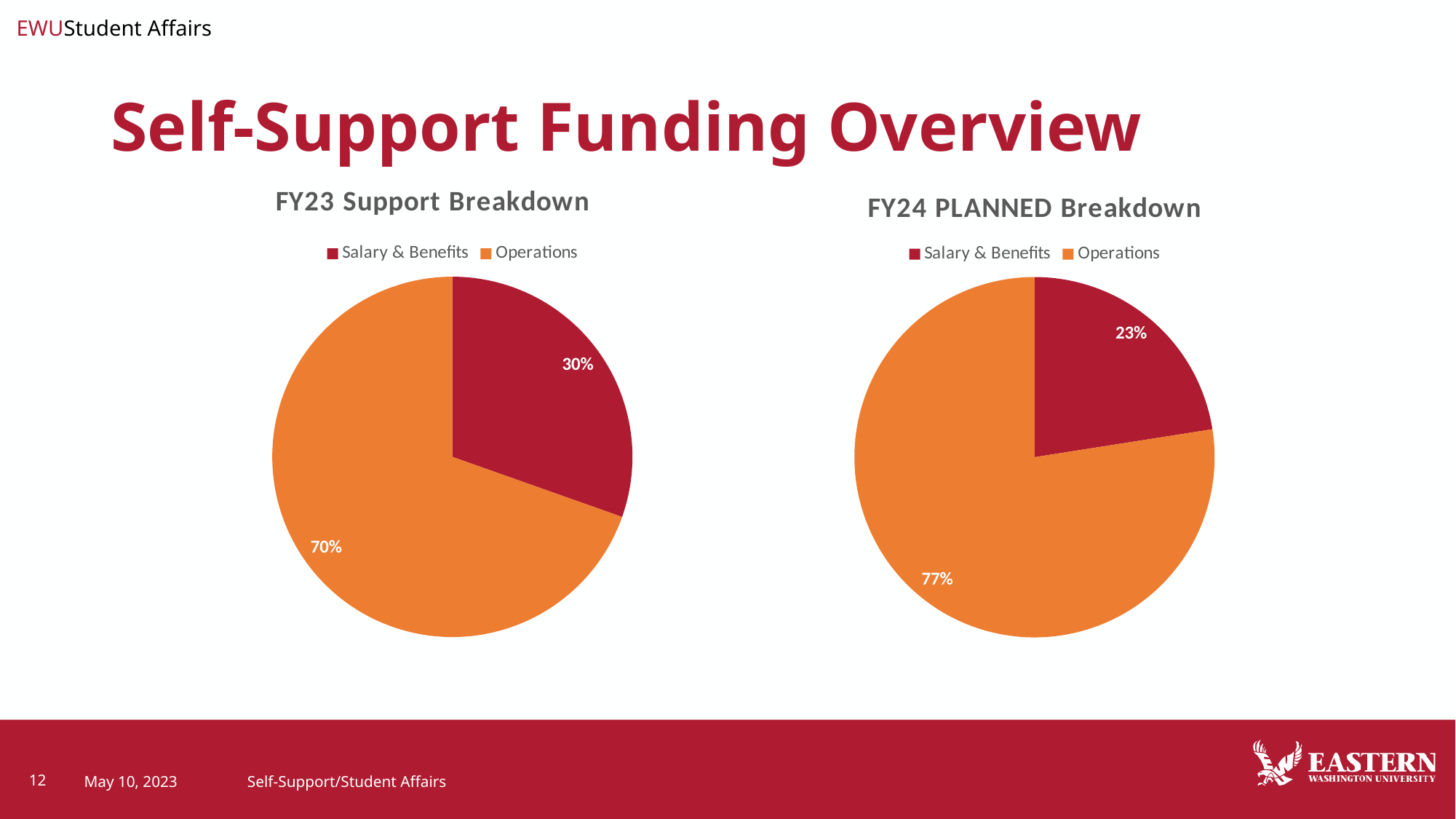
In the FY24 PLANNED Breakdown chart, what share does Salary & Benefits have? 23% In the FY24 PLANNED Breakdown chart, what share does Operations have? 77% What type of chart is the FY24 PLANNED Breakdown chart? Pie chart How many categories does the FY23 Support Breakdown chart show? 2 In the FY23 Support Breakdown chart, what is the difference between the Operations share and the Salary & Benefits share? 40% In the FY24 PLANNED Breakdown chart, what colour is the Operations slice? Orange In the FY23 Support Breakdown chart, which category has the largest slice? Operations In the FY23 Support Breakdown chart, what share does Operations have? 70% In the FY24 PLANNED Breakdown chart, which category has the smallest slice? Salary & Benefits Is the Salary & Benefits share larger in the FY23 Support Breakdown chart or the FY24 PLANNED Breakdown chart? FY23 Support Breakdown In the FY23 Support Breakdown chart, what share does Salary & Benefits have? 30% In the FY24 PLANNED Breakdown chart, what is the difference between the Operations share and the Salary & Benefits share? 54%